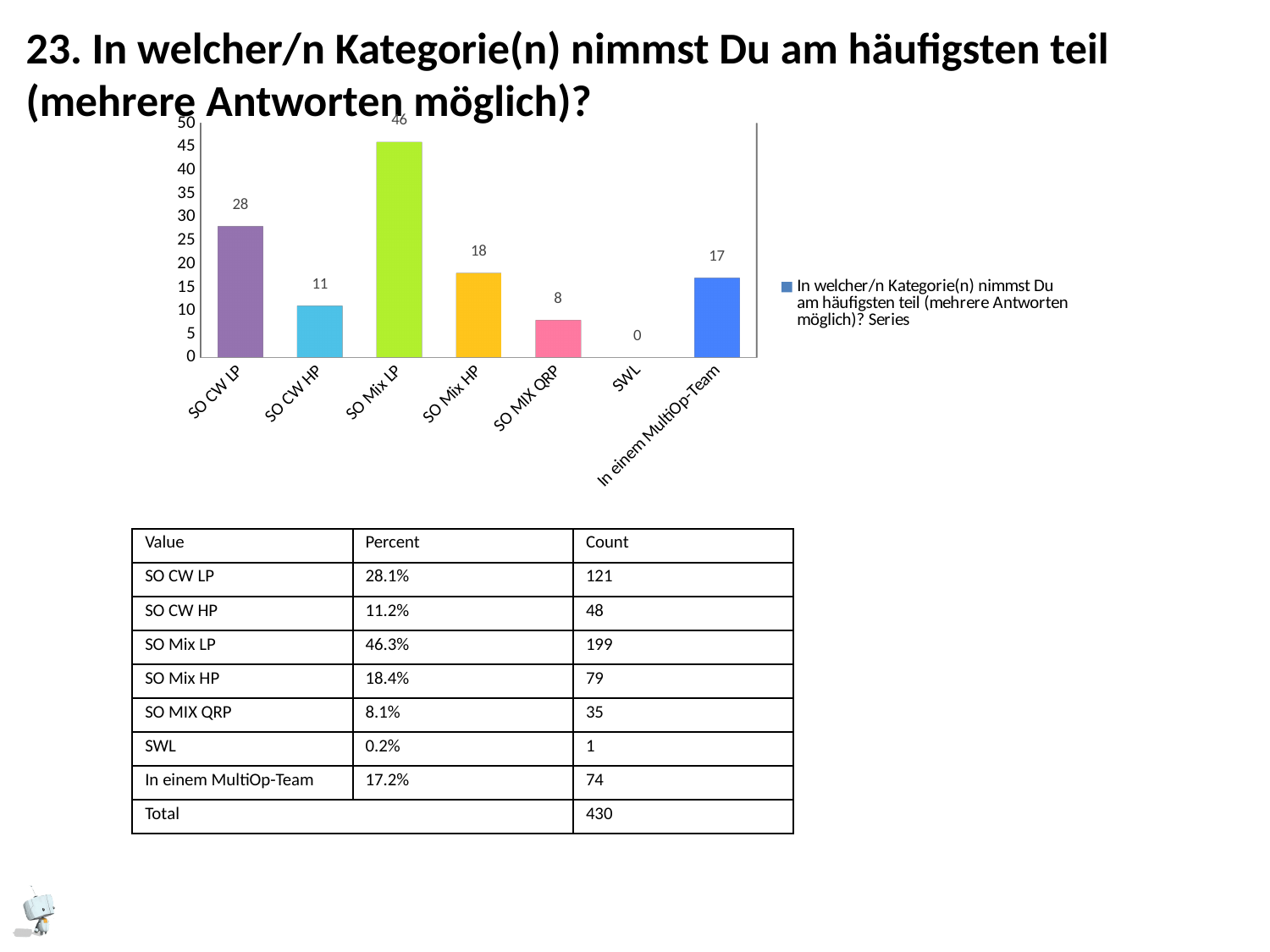
Which category has the highest value in the chart? SO Mix LP Which is larger in the chart, the value for SO CW HP or the value for In einem MultiOp-Team? In einem MultiOp-Team What is the difference between the values for SO Mix LP and SO CW LP in the chart? 18 What kind of chart is shown on the slide? Bar chart What is the difference between the values for SO Mix HP and SO MIX QRP in the chart? 10 What is the value shown for In einem MultiOp-Team in the chart? 17 What is the value shown for SWL in the chart? 0 Which category has the lowest value in the chart? SWL How many series does the chart legend list? 1 What is the value shown for SO CW LP in the chart? 28 How many categories are shown on the x axis of the chart? 7 What is the value shown for SO Mix LP in the chart? 46